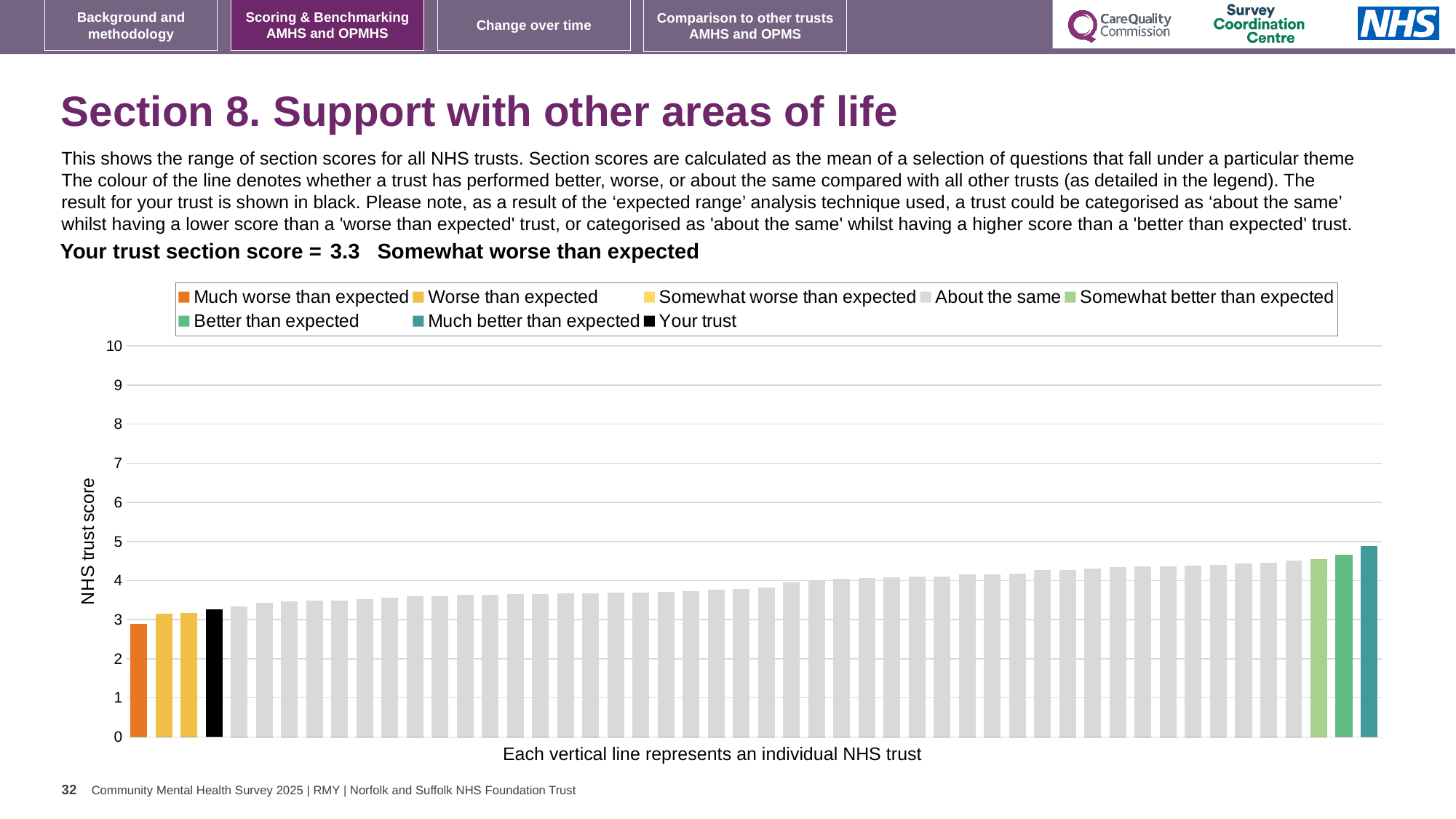
Is the value of the tallest bar greater or less than 4? greater Do the bar values rise or fall from left to right along the x axis? rise How many entries does the chart legend list? 8 How many bars are coloured orange (Much worse than expected)? 1 Is the value of the black 'Your trust' bar greater or less than 4? less Is the value of the tallest bar greater or less than 5? less Which is taller, the black 'Your trust' bar or the orange 'Much worse than expected' bar? the black 'Your trust' bar Which legend category does the tallest bar belong to? Much better than expected What is the section score for your trust? 3.3 What kind of chart is shown on the slide? bar chart What is the label on the y axis of the chart? NHS trust score Which legend category does the shortest bar belong to? Much worse than expected